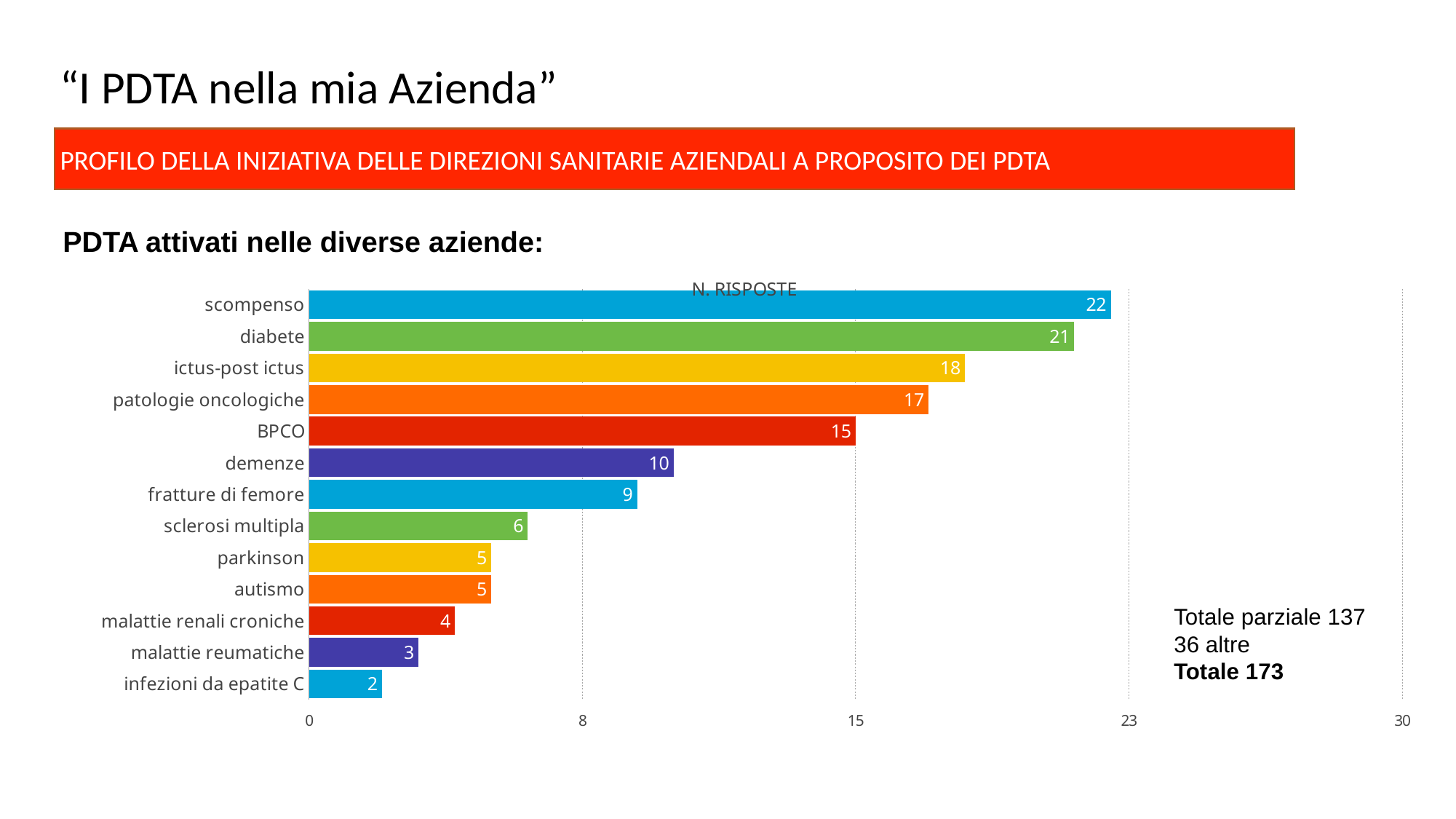
Is the value for fratture di femore greater or less than 8? greater What is the value for malattie renali croniche? 4 What is the difference between the values for diabete and demenze? 11 What kind of chart is shown on the slide? bar chart Which category has the highest value? scompenso How many categories are shown in the chart? 13 What is the title of the chart? N. RISPOSTE What is the value for BPCO? 15 Which category has the lowest value? infezioni da epatite C What is the value for scompenso? 22 What is the difference between the values for sclerosi multipla and malattie reumatiche? 3 Which is larger, the value for ictus-post ictus or the value for patologie oncologiche? ictus-post ictus